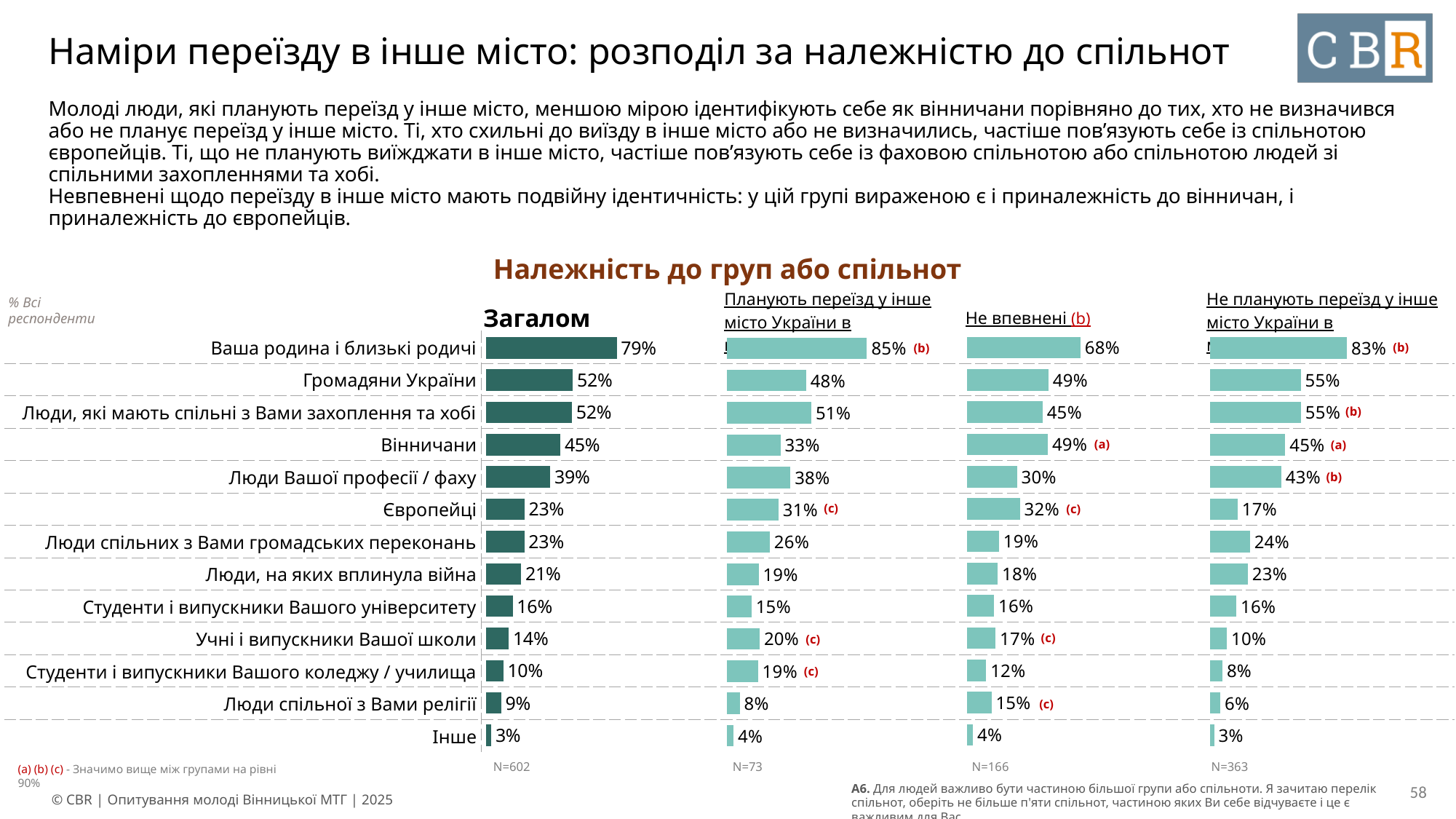
Which is larger: the value for 'Європейці' in the 'Не впевнені' chart or in the 'Не планують переїзд у інше місто України' chart? Не впевнені In the 'Планують переїзд у інше місто України' chart, what is the difference between 'Ваша родина і близькі родичі' and 'Громадяни України'? 37% How many categories are shown in the 'Загалом' chart? 13 In the 'Не впевнені' chart, what is the value for 'Вінничани'? 49% In the 'Не впевнені' chart, which category has the highest value? Ваша родина і близькі родичі What is the sample size (N) shown under the 'Не впевнені' chart? N=166 In the 'Не планують переїзд у інше місто України' chart, what is the value for 'Люди Вашої професії / фаху'? 43% In the 'Загалом' chart, which category has the lowest value? Інше What type of chart is used on this slide? Bar chart In the 'Планують переїзд у інше місто України' chart, what is the value for 'Європейці'? 31% In the 'Не планують переїзд у інше місто України' chart, what is the difference between 'Громадяни України' and 'Вінничани'? 10% In the 'Загалом' chart, what is the value for 'Ваша родина і близькі родичі'? 79%